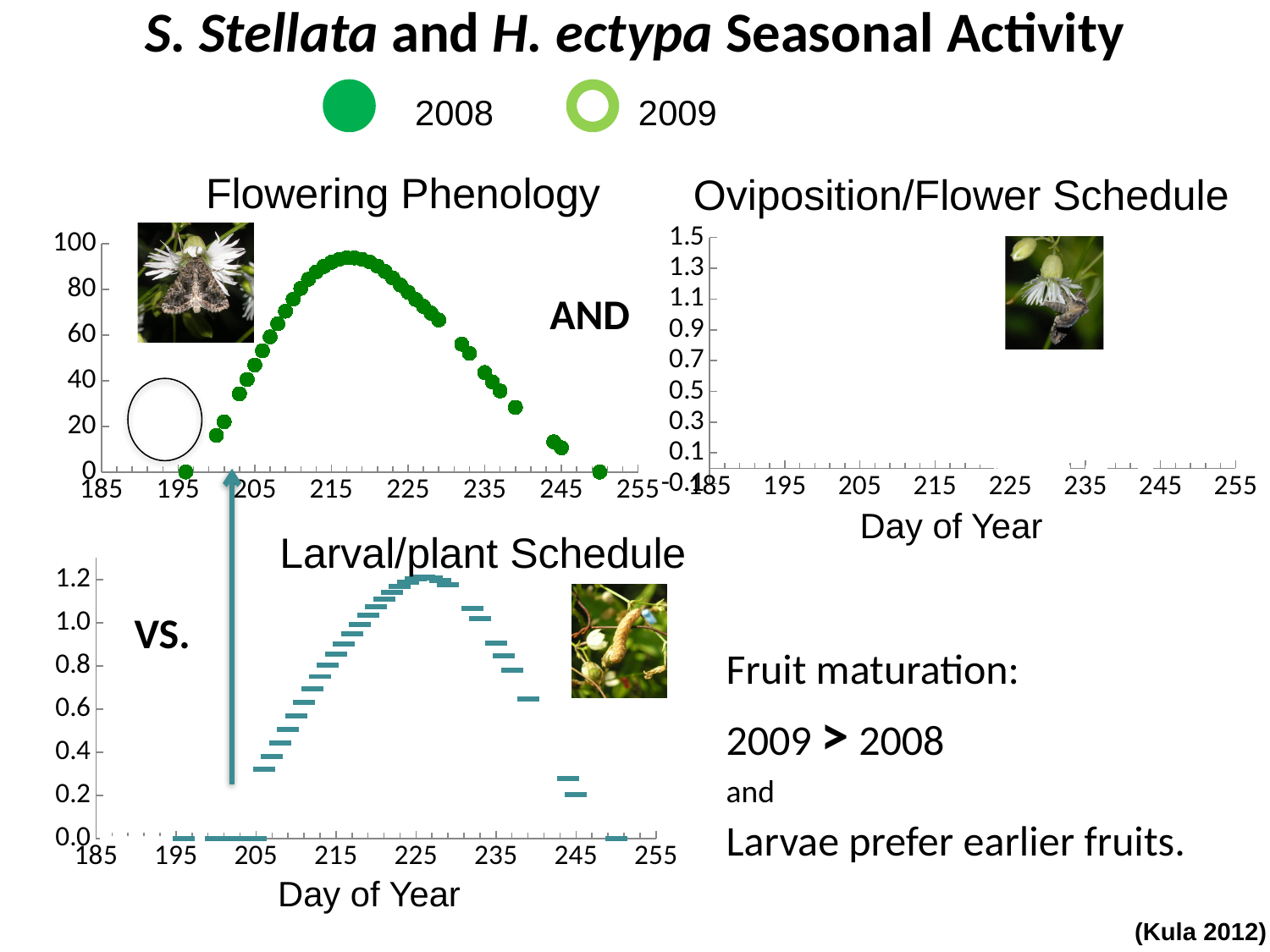
In the Flowering Phenology chart, is the value at day 245 greater or less than 40? less In the Larval/plant Schedule chart, which is larger, the value at day 225 or the value at day 245? day 225 What kind of chart is the Flowering Phenology chart? scatter chart In the Flowering Phenology chart, do the values rise or fall between day 225 and day 245? fall In the Flowering Phenology chart, is the value at day 195 greater or less than 20? less What is the x-axis title of the Larval/plant Schedule chart? Day of Year In the Flowering Phenology chart, is the value at day 215 greater or less than 80? greater How many charts are shown on the slide? 3 In the Flowering Phenology chart, do the values rise or fall between day 205 and day 215? rise What are the two legend entries shown at the top of the slide? 2008 and 2009